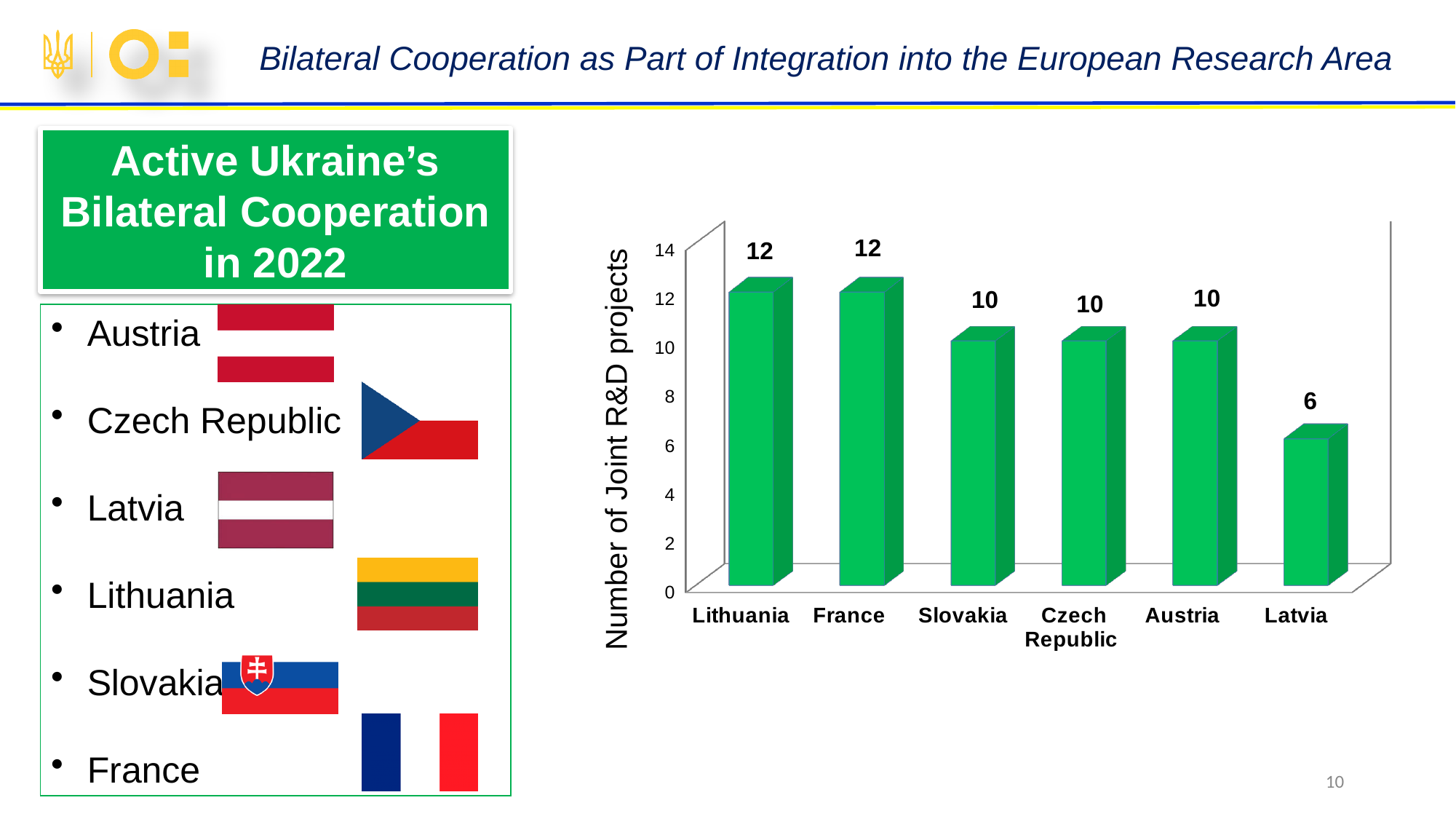
What kind of chart is shown on the slide? bar chart Do the values generally rise or fall from left to right along the x axis? fall Is the value for Latvia greater or less than 8? less What is the number of joint R&D projects for Latvia? 6 How many joint R&D projects does the chart show for Lithuania? 12 Which country has the lowest number of joint R&D projects? Latvia What is the difference between the values for Lithuania and Austria? 2 Which is larger, the value for France or the value for Czech Republic? France What is the label of the vertical axis of the chart? Number of Joint R&D projects How many countries are shown on the x axis of the chart? 6 What is the value shown for Slovakia? 10 What is the difference between the values for France and Latvia? 6